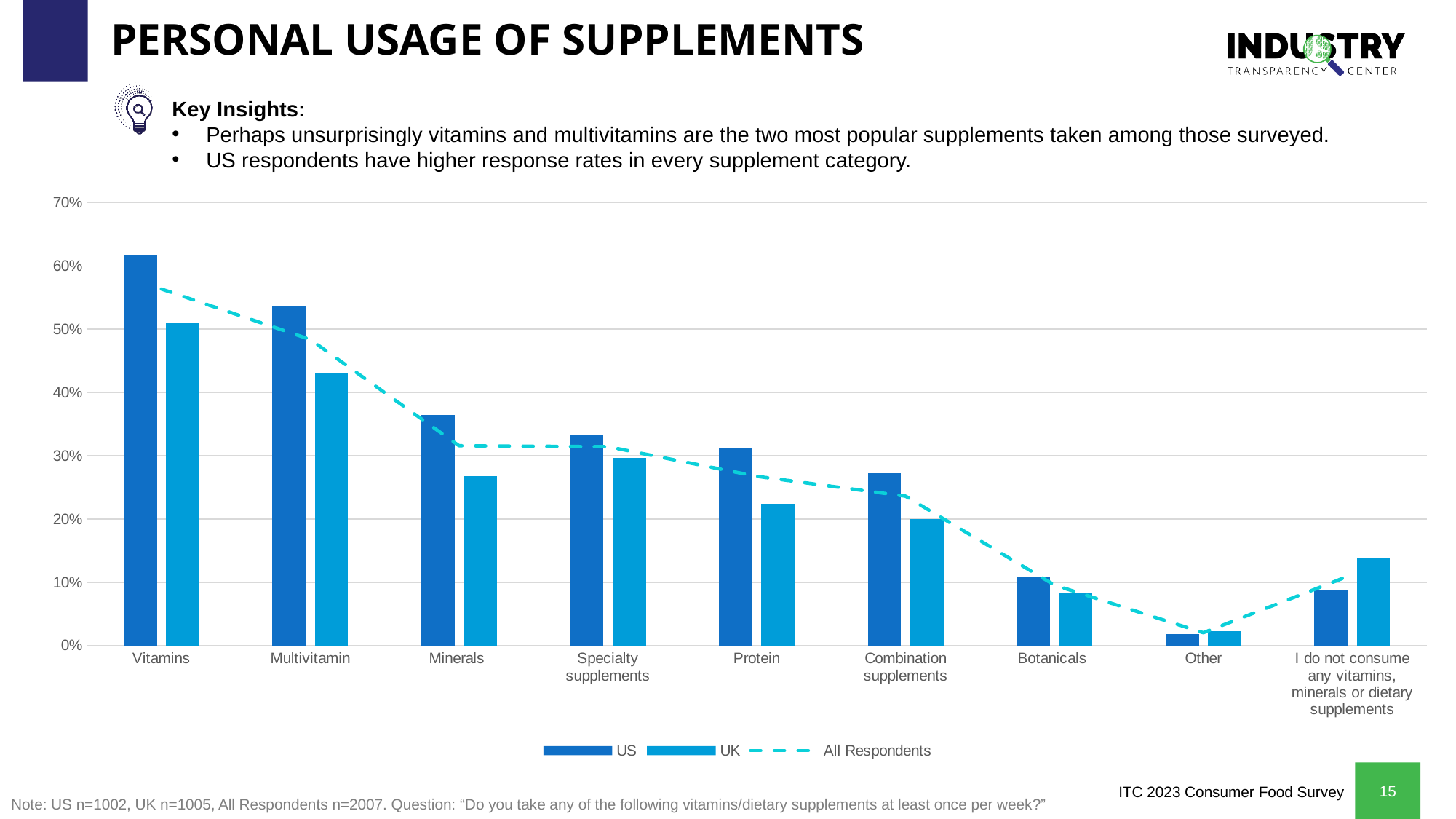
For Vitamins, which is larger, the US value or the UK value? US How many series does the legend list? 3 Does the All Respondents line rise or fall from Vitamins to Other? Falls Which category has the lowest US value? Other What kind of chart is shown on the slide? Bar chart with a dashed line How many supplement categories are shown along the x axis? 9 Which category has the highest US value? Vitamins Is the UK value for Minerals greater or less than 30%? less For 'I do not consume any vitamins, minerals or dietary supplements', which is larger, the US value or the UK value? UK Is the UK value for 'I do not consume any vitamins, minerals or dietary supplements' greater or less than 10%? greater Is the US value for Botanicals greater or less than 20%? less